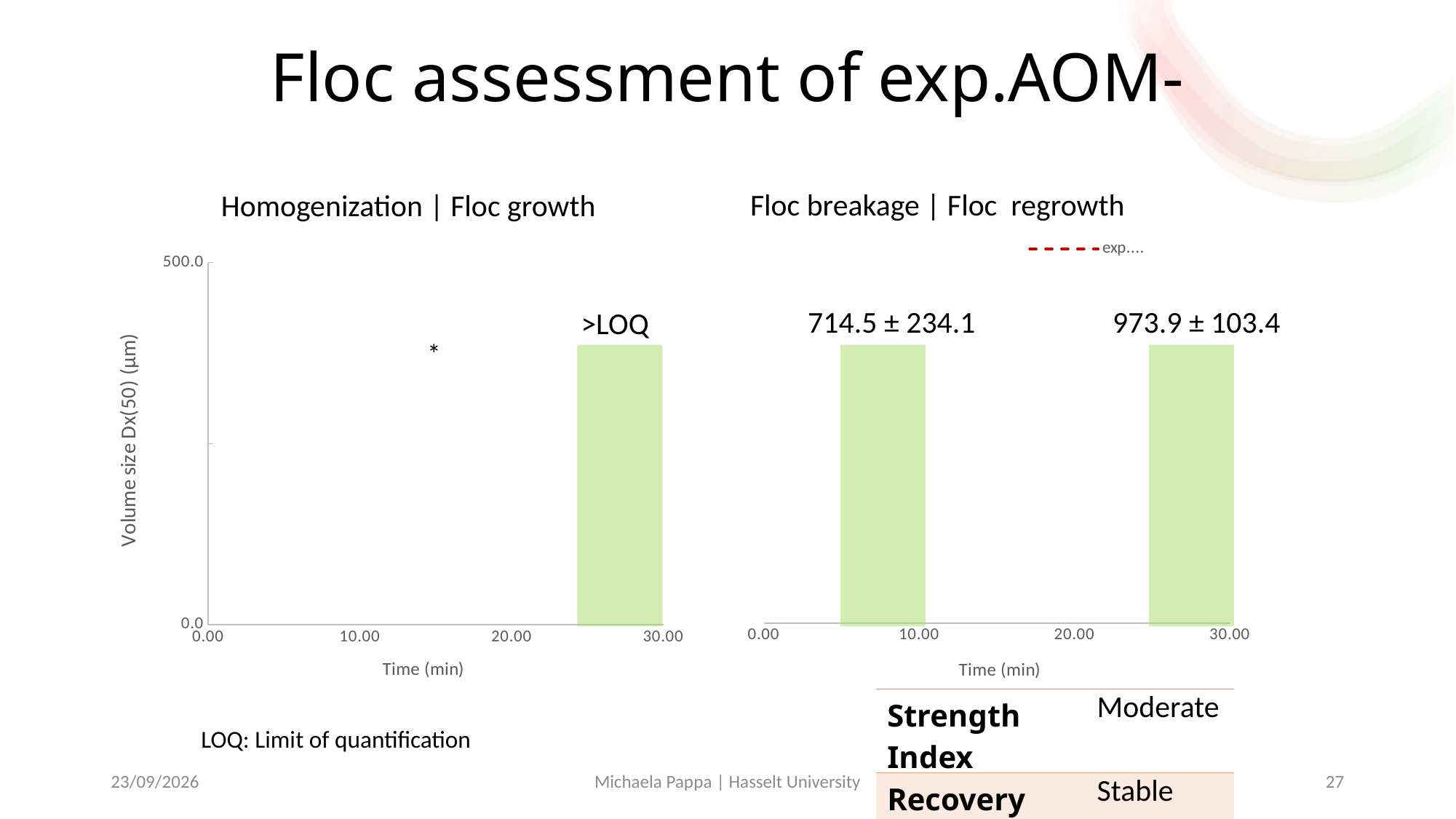
In the 'Floc breakage | Floc regrowth' chart, which bar is the highest? The bar near 25–30 min (973.9 ± 103.4) In the 'Floc breakage | Floc regrowth' chart, what value is printed above the bar near 5–10 min? 714.5 ± 234.1 In the 'Floc breakage | Floc regrowth' chart, what value is printed above the bar near 25–30 min? 973.9 ± 103.4 What kind of chart is the 'Homogenization | Floc growth' chart? Bar chart What is the y-axis label of the 'Homogenization | Floc growth' chart? Volume size Dx(50) (µm) In the 'Floc breakage | Floc regrowth' chart, what is the difference between the central values 973.9 and 714.5? 259.4 How many bars are plotted in the 'Floc breakage | Floc regrowth' chart? 2 In the 'Floc breakage | Floc regrowth' chart, which bar is the lowest? The bar near 5–10 min (714.5 ± 234.1) In the 'Floc breakage | Floc regrowth' chart, is the bar near 5–10 min or the bar near 25–30 min larger? The bar near 25–30 min In the 'Homogenization | Floc growth' chart, what label is printed above the bar near 25–30 min? >LOQ How many bars are plotted in the 'Homogenization | Floc growth' chart? 1